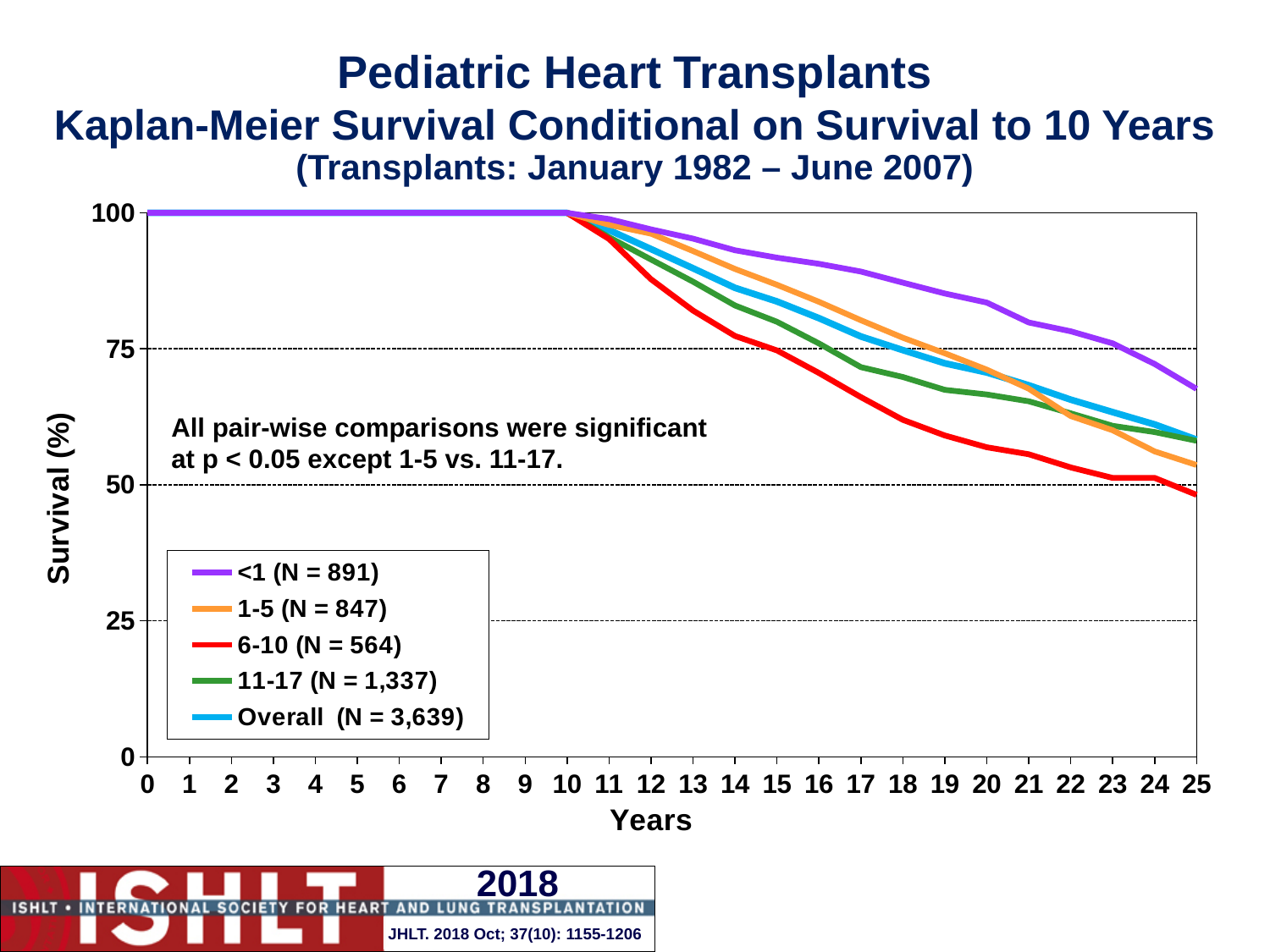
What is the survival (%) for the 6-10 group at year 5? 100 How many series does the legend list? 5 Is the survival for the <1 group at year 20 greater or less than 75? greater What is the survival (%) for the Overall group at year 10? 100 Is the survival for the Overall group at year 25 greater or less than 50? greater Which age group has the lowest survival at year 25? 6-10 (N = 564) What kind of chart is shown on the slide? line chart Do the survival curves rise or fall along the x axis after year 10? fall Is the survival for the 6-10 group at year 17 greater or less than 75? less At year 20, which is larger: the survival for the 1-5 group or the 6-10 group? 1-5 group According to the legend, what is the N for the Overall group? 3,639 Which age group has the highest survival at year 25? <1 (N = 891)